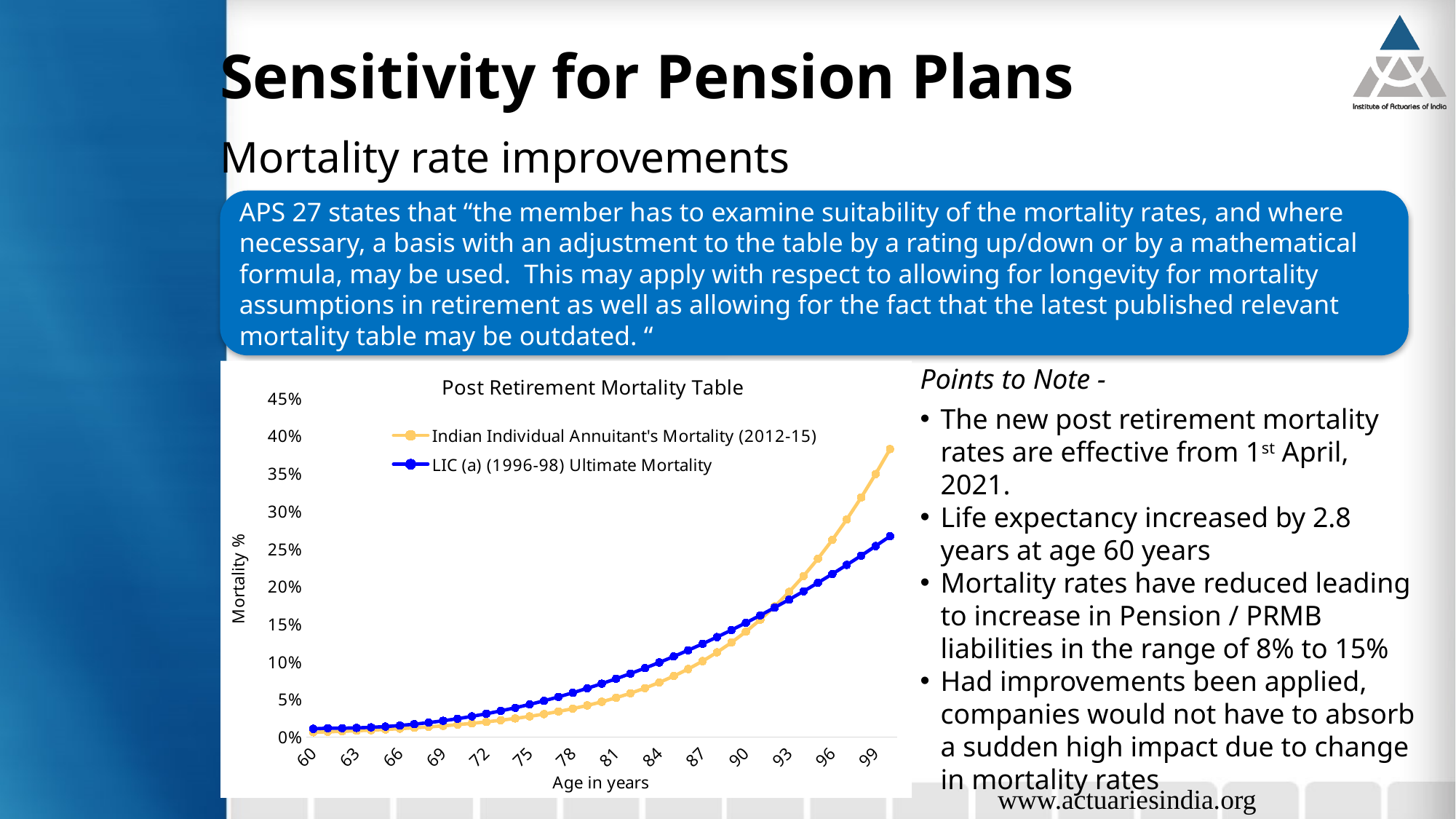
How many series does the chart legend list? 2 What is the label of the y axis? Mortality % Is the final value of the LIC (a) (1996-98) Ultimate Mortality series greater or less than 30%? less What is the title of the chart? Post Retirement Mortality Table What type of chart is shown on the slide? Line chart At age 75, which series has the higher mortality rate? LIC (a) (1996-98) Ultimate Mortality Is the final value of the Indian Individual Annuitant's Mortality (2012-15) series greater or less than 35%? greater Is the value for LIC (a) (1996-98) Ultimate Mortality at age 60 greater or less than 5%? less At the right end of the chart (the oldest age), which series has the higher mortality rate? Indian Individual Annuitant's Mortality (2012-15) Do the mortality rates rise or fall as age increases along the x axis? Rise Which series is drawn in blue? LIC (a) (1996-98) Ultimate Mortality